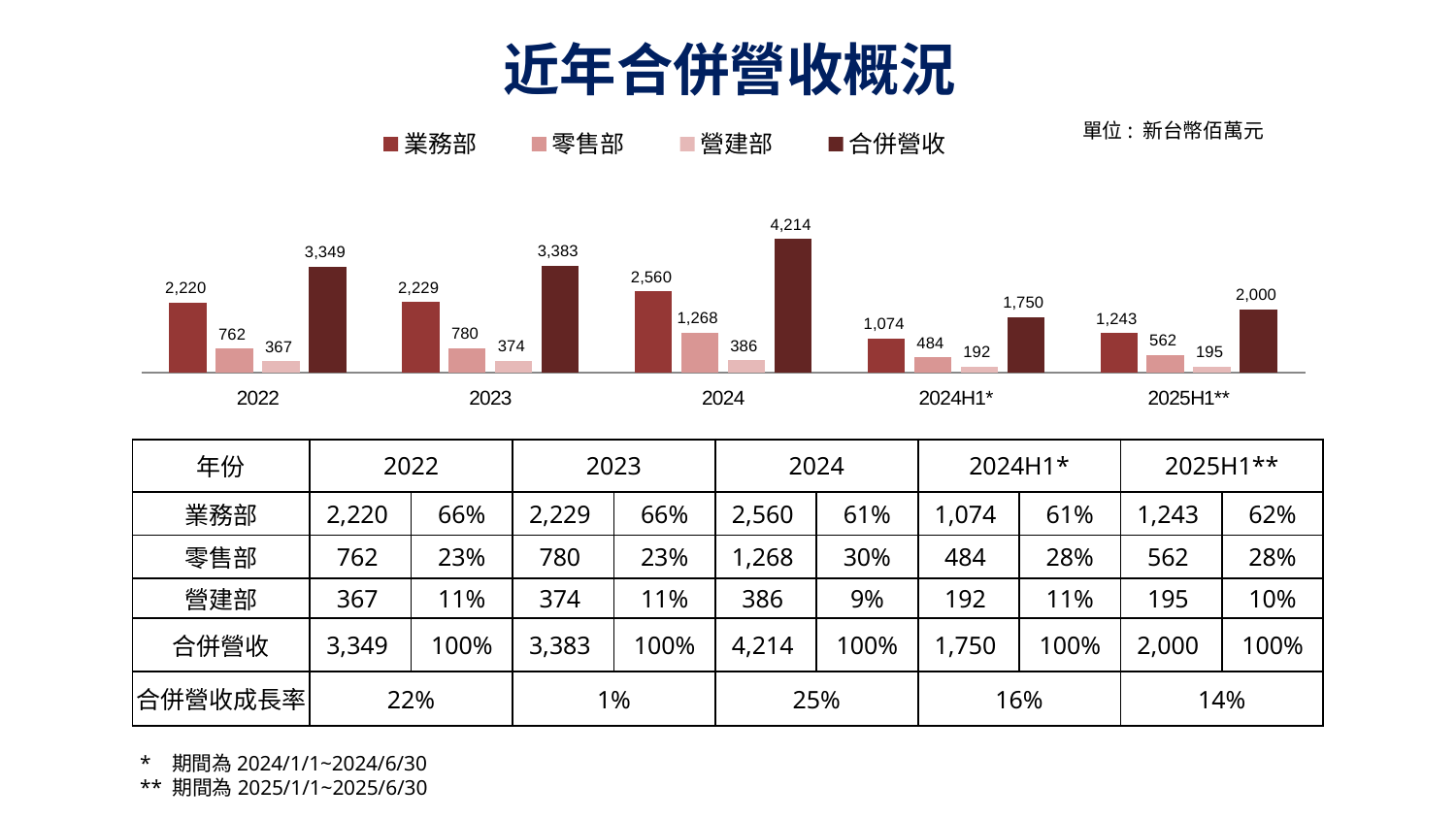
Which category has the lowest 零售部 value? 2024H1* How many series does the legend list? 4 What is the title of the chart? 近年合併營收概況 Which is larger: 零售部 in 2024 or 零售部 in 2023? 零售部 in 2024 What is the value for 合併營收 in 2025H1**? 2,000 Does the 業務部 value rise or fall from 2022 to 2024? rise What kind of chart is shown? bar chart What is the value for 營建部 in 2023? 374 What is the difference between 合併營收 in 2024 and 2023? 831 Which year has the highest 合併營收? 2024 How many categories are shown on the x axis? 5 What is the value for 業務部 in 2024? 2,560